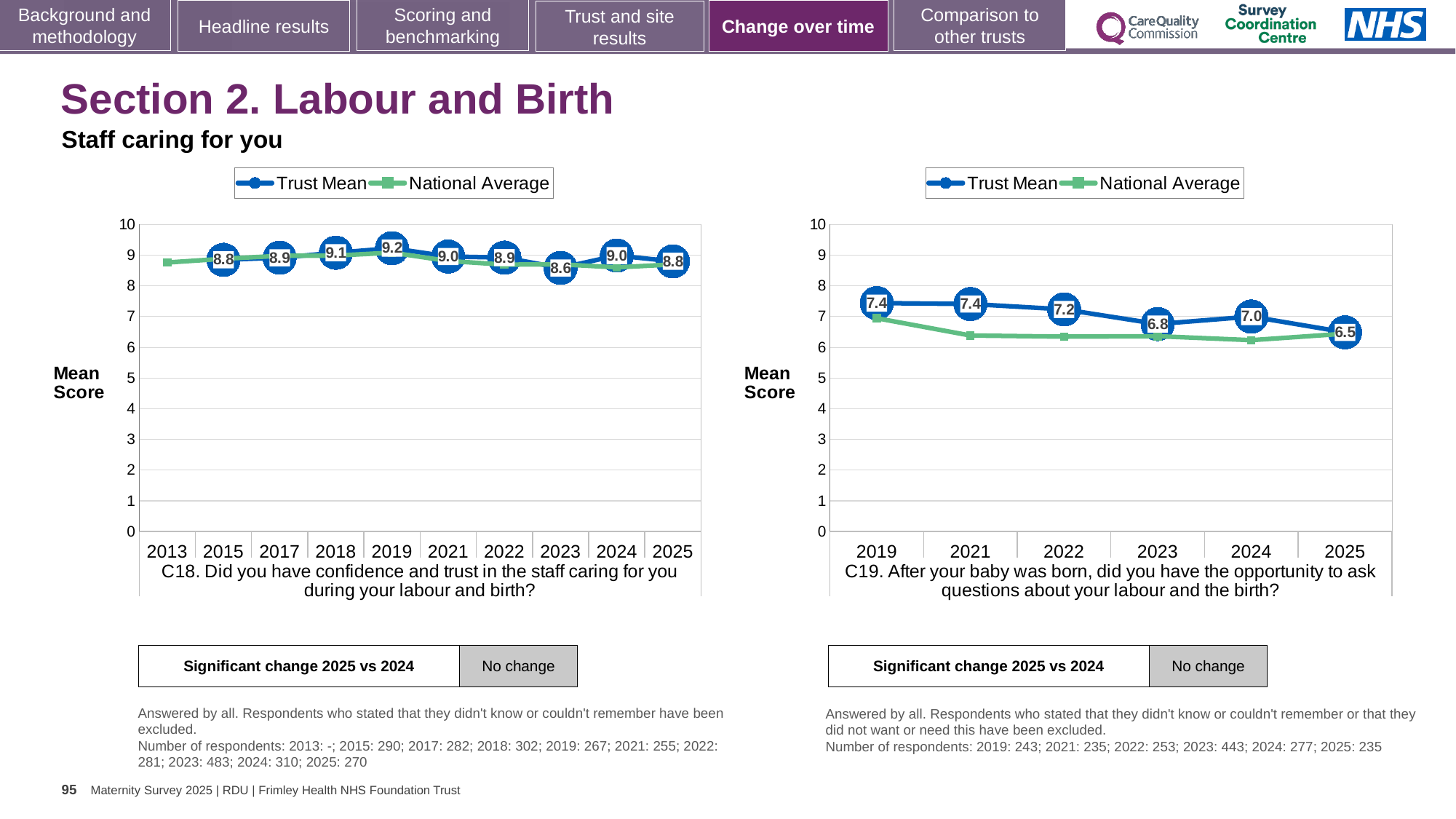
In the C19 chart on the right, is the National Average for 2021 greater or less than 7? less In the C19 chart on the right, what is the Trust Mean for 2025? 6.5 In the C18 chart on the left, which year has the highest Trust Mean? 2019 How many series does the legend of the C18 chart on the left list? 2 In the C19 chart on the right, what is the difference between the Trust Mean for 2019 and the Trust Mean for 2025? 0.9 In the C18 chart on the left, is the Trust Mean higher in 2024 or in 2023? 2024 In the C19 chart on the right, does the Trust Mean generally rise or fall from 2019 to 2025? Fall In the C18 chart on the left, what is the Trust Mean for 2023? 8.6 How many years are shown on the x axis of the C19 chart on the right? 6 What kind of chart is the C19 chart on the right? Line chart In the C18 chart on the left, what is the Trust Mean for 2019? 9.2 In the C19 chart on the right, which year has the lowest Trust Mean? 2025